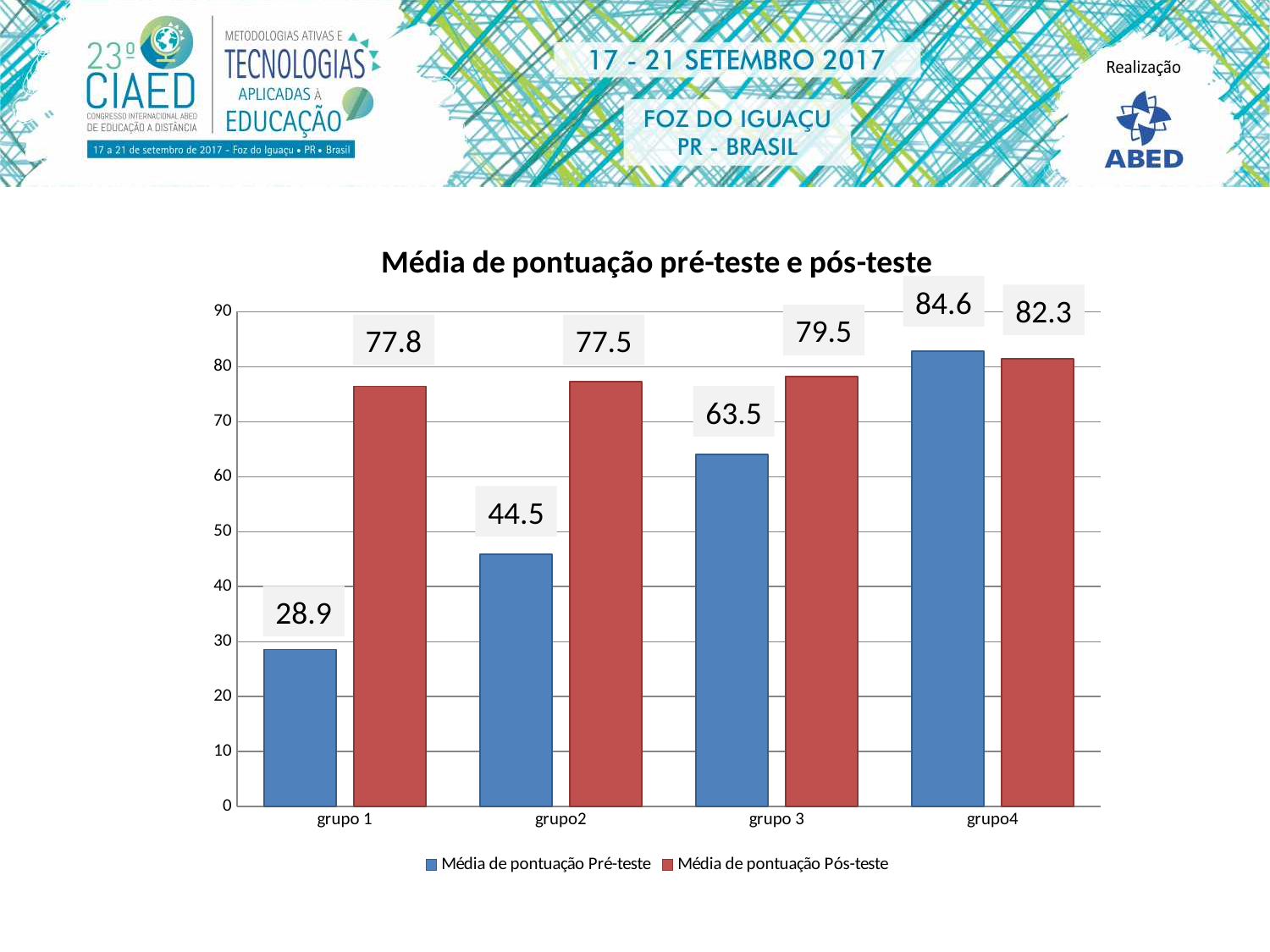
What kind of chart is shown on the slide? bar chart What is the Média de pontuação Pós-teste value for grupo 3? 79.5 For grupo4, which is larger: the Pré-teste value or the Pós-teste value? Pré-teste Which group has the lowest Média de pontuação Pré-teste? grupo 1 How many groups are shown on the x axis? 4 What is the difference between the Pós-teste and Pré-teste values for grupo2? 33 Do the Média de pontuação Pré-teste values rise or fall from grupo 1 to grupo4? rise What is the Média de pontuação Pré-teste value for grupo4? 84.6 Which group has the highest Média de pontuação Pós-teste? grupo4 How many series does the legend list? 2 What is the Média de pontuação Pré-teste value for grupo 1? 28.9 Is the Média de pontuação Pré-teste value for grupo 3 greater or less than 60? greater